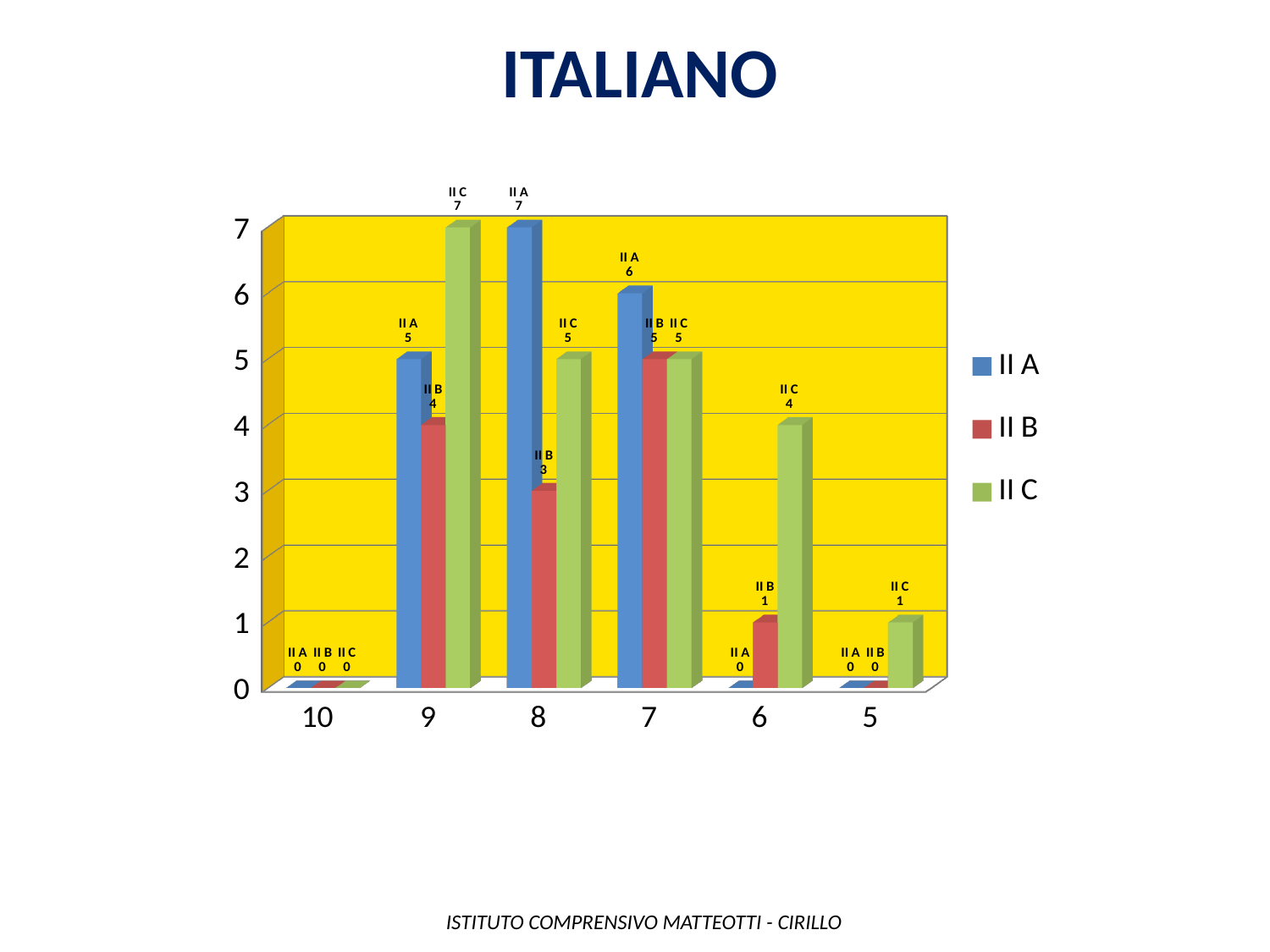
At which grade does II A reach its highest value? 8 How many grade categories are shown on the x axis? 6 What is the value for II B at grade 8? 3 At which grade does II C have its lowest value? 10 How many series does the legend list? 3 What is the title of the chart? ITALIANO What is the difference between II C and II B at grade 9? 3 What is the value for II C at grade 9? 7 What is the value for II A at grade 7? 6 What is the value for II C at grade 6? 4 What kind of chart is shown on the slide? bar chart At grade 8, which series has the larger value, II A or II C? II A